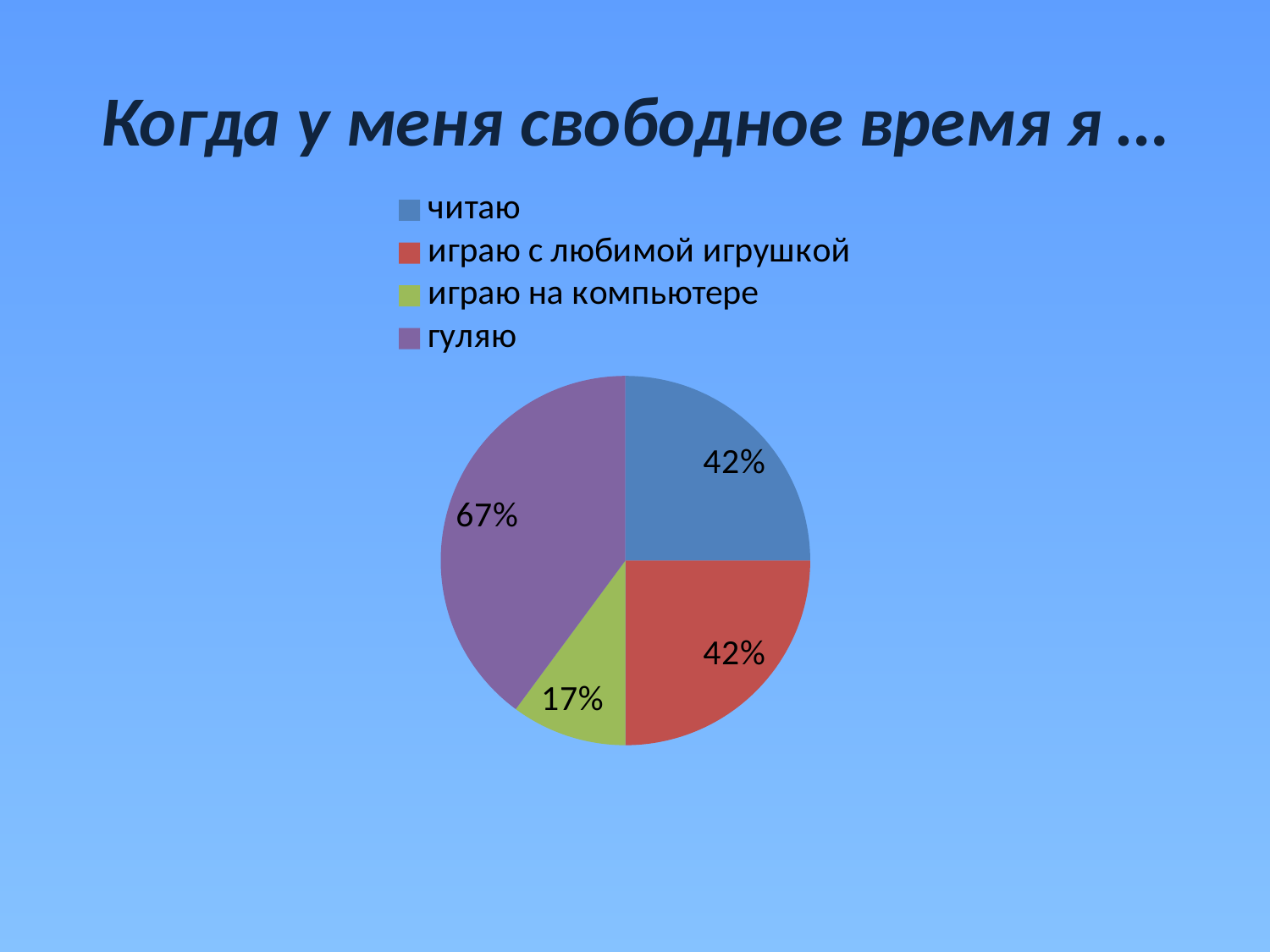
What value is shown for the slice 'читаю'? 42% Which is larger, the slice for 'гуляю' or the slice for 'читаю'? гуляю How many entries does the legend list? 4 What value is shown for the slice 'играю с любимой игрушкой'? 42% What is the difference between the values shown for 'гуляю' and 'играю на компьютере'? 50% How many slices does the pie chart have? 4 What value is shown for the slice 'гуляю'? 67% Which slice of the pie chart is the largest? гуляю What value is shown for the slice 'играю на компьютере'? 17% Which slice of the pie chart is the smallest? играю на компьютере What is the title of the chart? Когда у меня свободное время я … What kind of chart is shown on the slide? pie chart